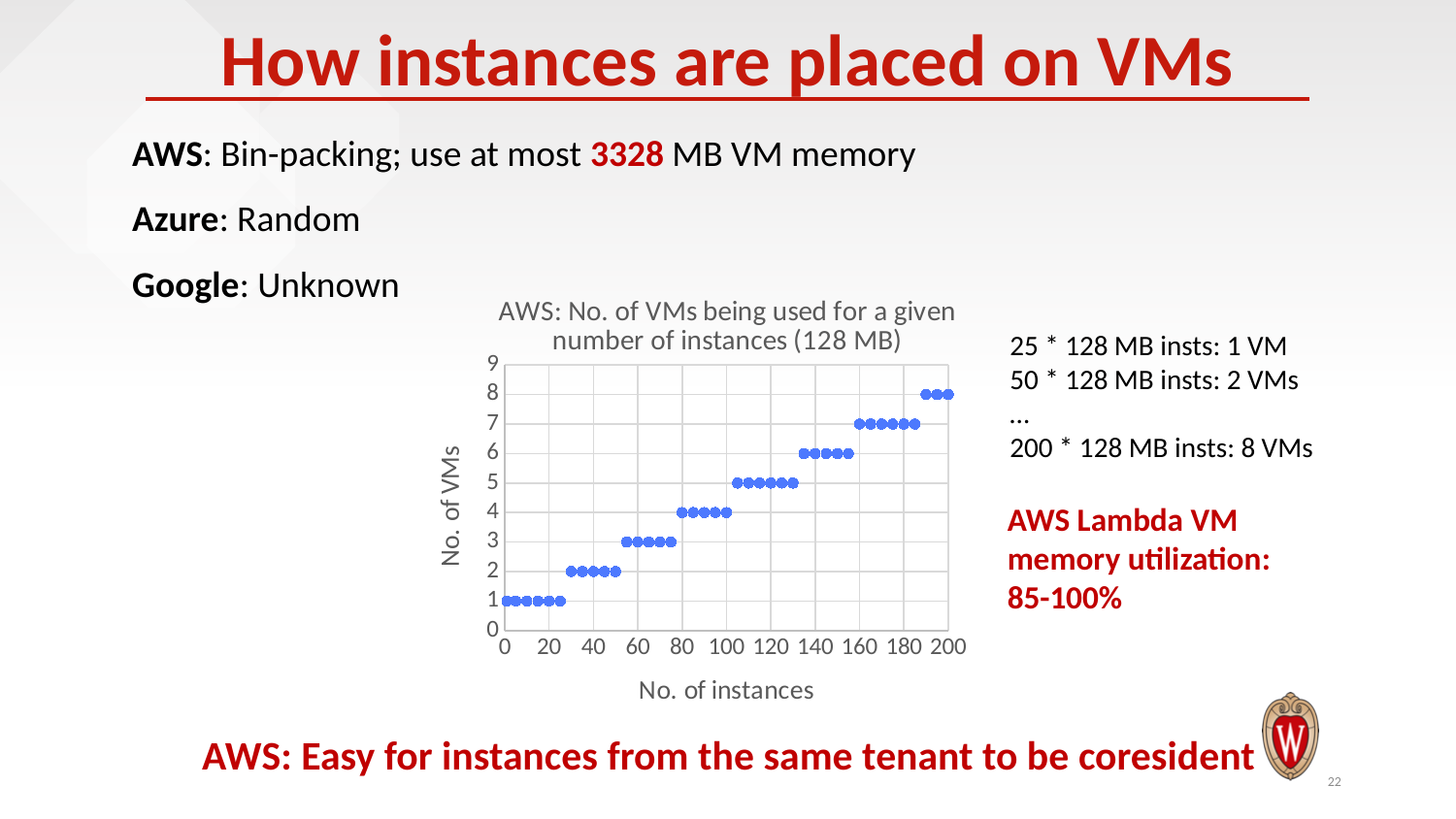
What is the title of the chart? AWS: No. of VMs being used for a given number of instances (128 MB) Do the number of VMs rise or fall as the number of instances increases along the x axis? rise According to the chart, how many VMs are used for 25 instances? 1 What is the highest number of VMs reached by any point on the chart? 8 What is the label of the x axis of the chart? No. of instances According to the chart, how many VMs are used for 50 instances? 2 According to the chart, how many VMs are used for 200 instances? 8 What kind of chart is shown on the slide? scatter chart How many more VMs are used for 200 instances than for 25 instances? 7 Is the number of VMs for 100 instances greater or less than 6? less Is the number of VMs for 180 instances greater or less than 5? greater What is the lowest number of VMs shown by any point on the chart? 1